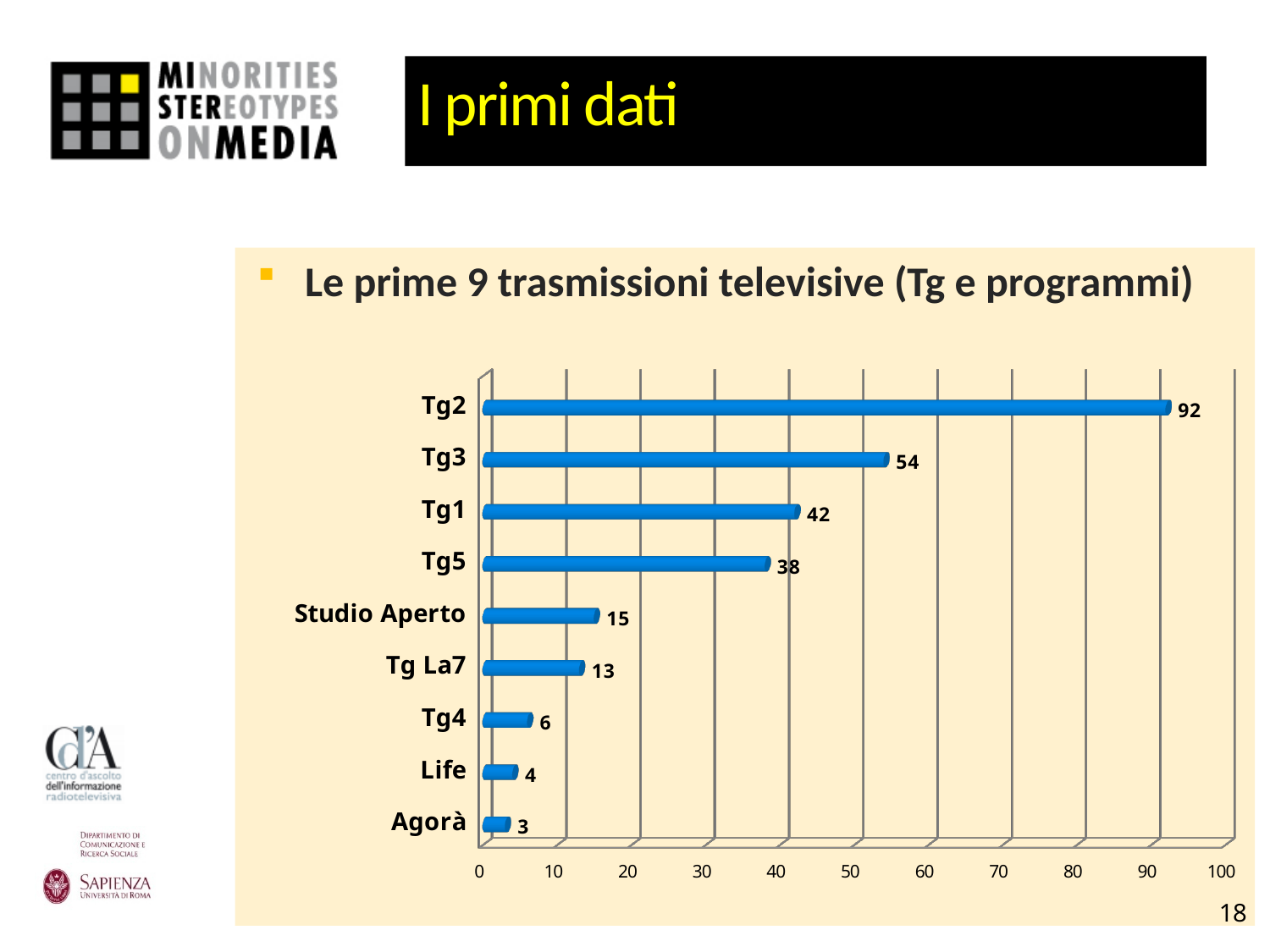
Which category has the highest value? Tg2 What is the difference between the values for Tg2 and Agorà? 89 What is the value for Studio Aperto? 15 What is the value for Tg2? 92 What is the difference between the values for Tg3 and Tg1? 12 Which category has the lowest value? Agorà What is the value for Tg5? 38 Which is larger, the value for Tg La7 or the value for Tg4? Tg La7 Is the value for Tg1 greater or less than 40? greater How many categories are shown in the chart? 9 What is the value for Life? 4 What kind of chart is shown on the slide? bar chart